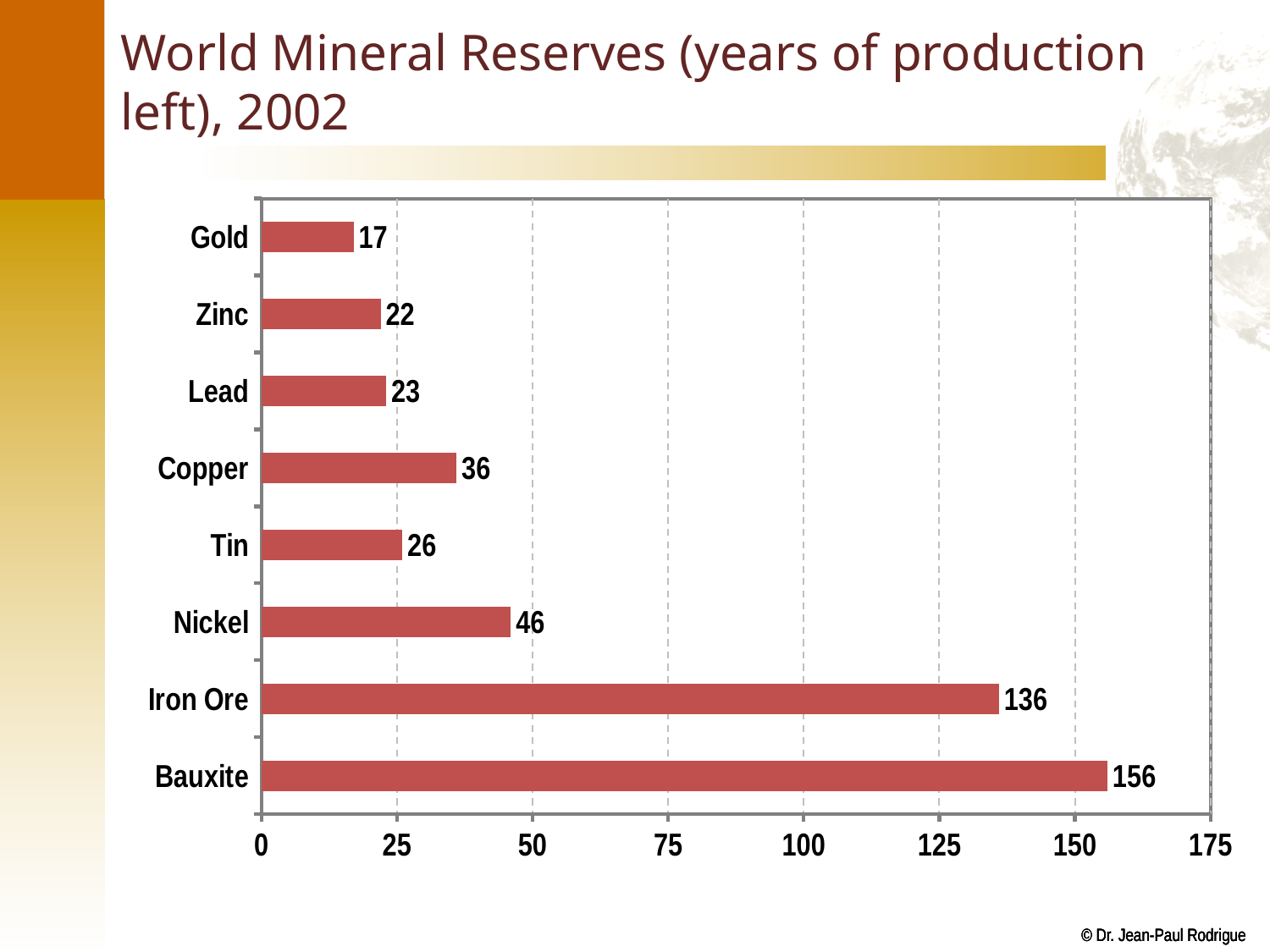
What is the title of the slide? World Mineral Reserves (years of production left), 2002 Which has a larger value, Copper or Tin? Copper What is the difference between the values for Bauxite and Iron Ore? 20 What is the difference between the values for Nickel and Tin? 20 What is the value shown for Gold? 17 How many years of production are left for Bauxite? 156 Which mineral has the fewest years of production left? Gold What is the value shown for Copper? 36 What kind of chart is shown on the slide? Bar chart Is the value for Iron Ore greater or less than 125? greater Which mineral has the most years of production left? Bauxite How many minerals are shown in the chart? 8